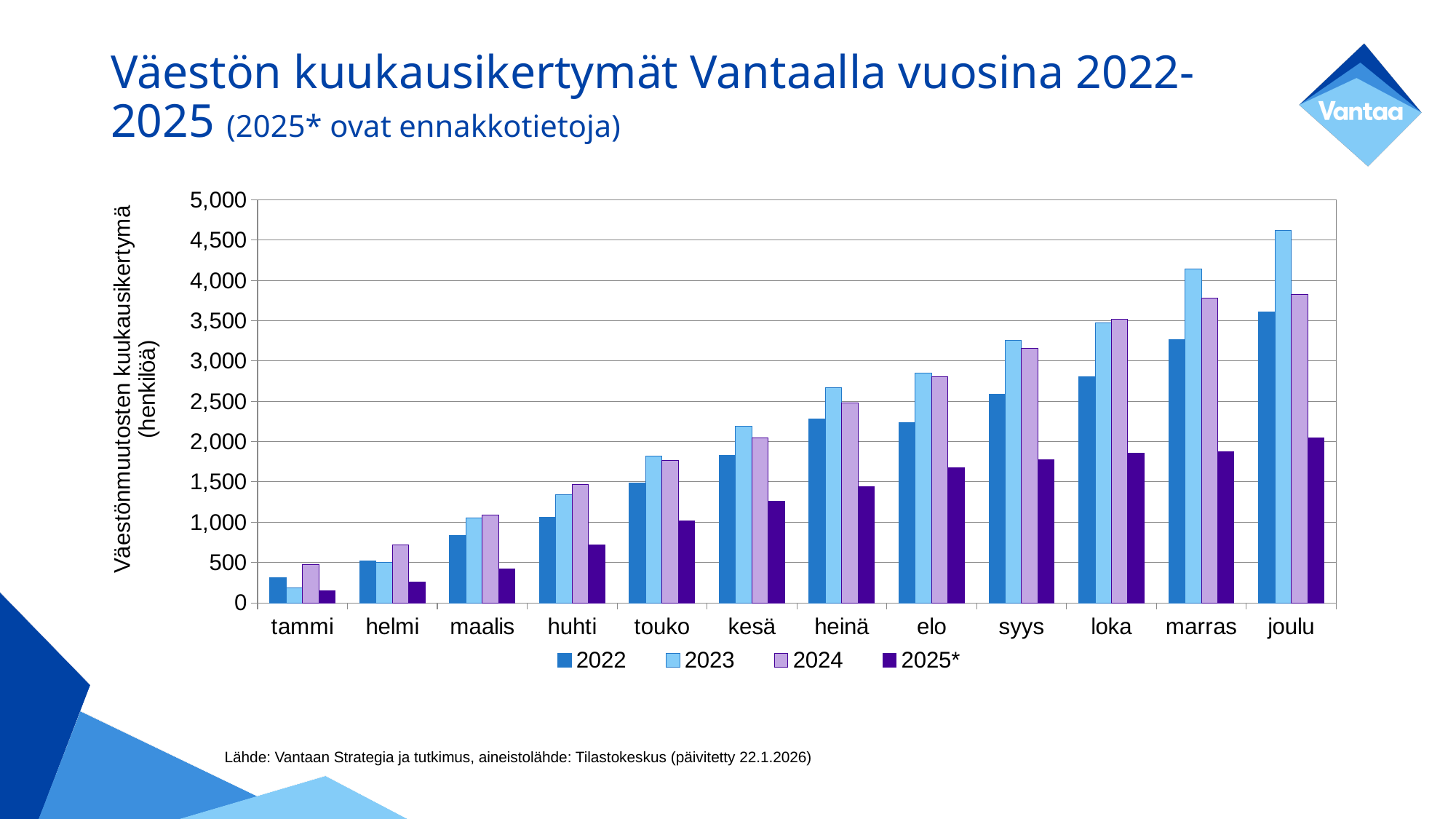
For marras, which series has the larger value, 2023 or 2024? 2023 What is the label of the vertical axis? Väestönmuutosten kuukausikertymä (henkilöä) How many months are shown on the x axis? 12 For heinä, which series has the larger value, 2022 or 2025*? 2022 Which month has the lowest value for the 2025* series? tammi Is the 2023 value for joulu greater or less than 4,500? greater Do the values for the 2023 series rise or fall from tammi to joulu? rise How many series does the legend list? 4 Which month has the highest value for the 2023 series? joulu Is the 2022 value for syys greater or less than 3,000? less Is the 2025* value for joulu greater or less than 2,500? less What kind of chart is shown on the slide? bar chart